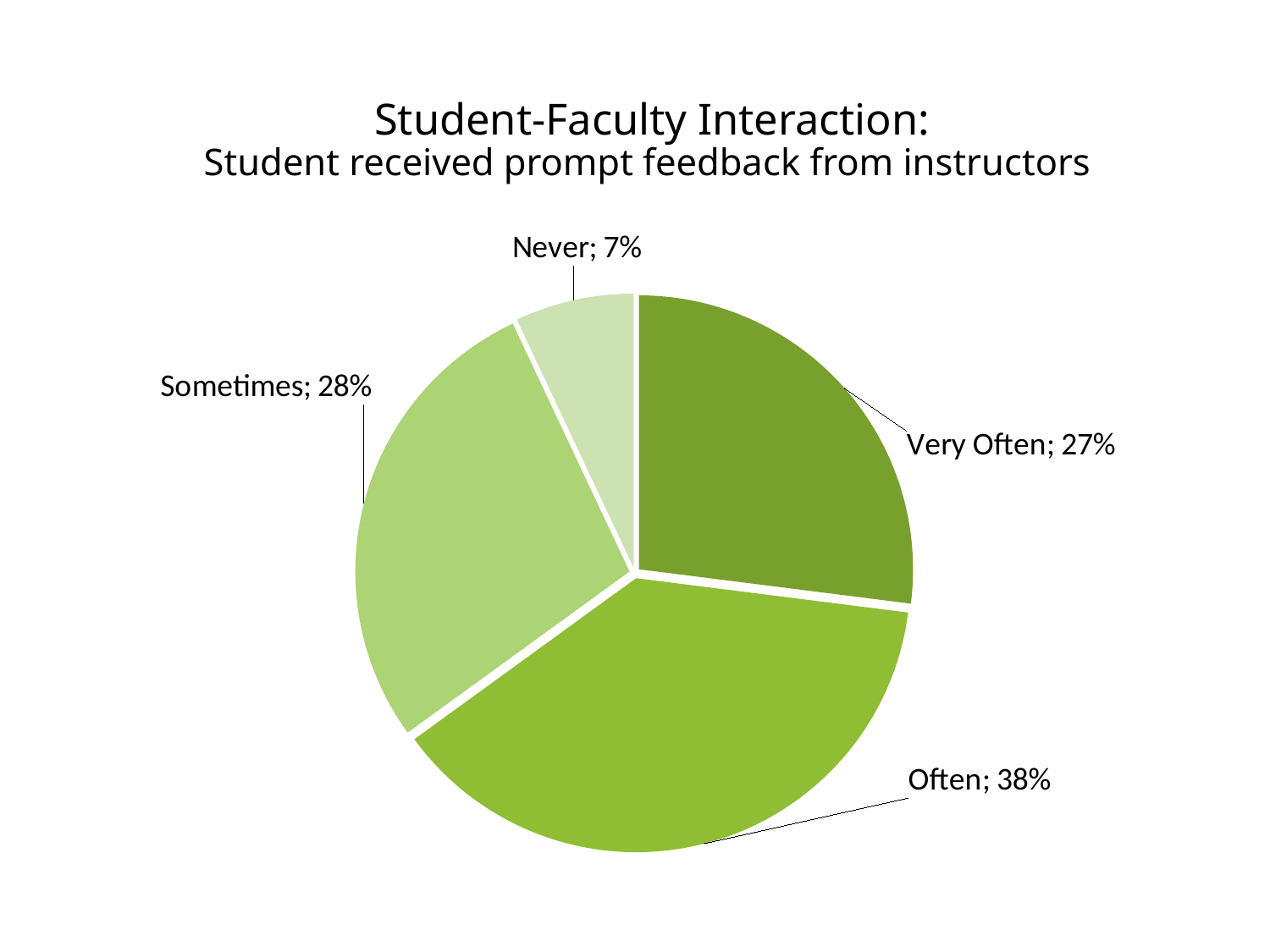
What is the title of the chart? Student-Faculty Interaction: Student received prompt feedback from instructors What percentage of students answered "Often"? 38% What is the difference in percentage points between "Often" and "Never"? 31 Which is larger, the share for "Often" or the share for "Sometimes"? Often What is the difference in percentage points between "Sometimes" and "Very Often"? 1 What kind of chart is shown on the slide? pie chart What percentage of students answered "Sometimes"? 28% Which response category has the largest share of the pie? Often How many slices does the pie chart have? 4 What percentage of students answered "Very Often"? 27% What percentage of students answered "Never"? 7% Which response category has the smallest share of the pie? Never